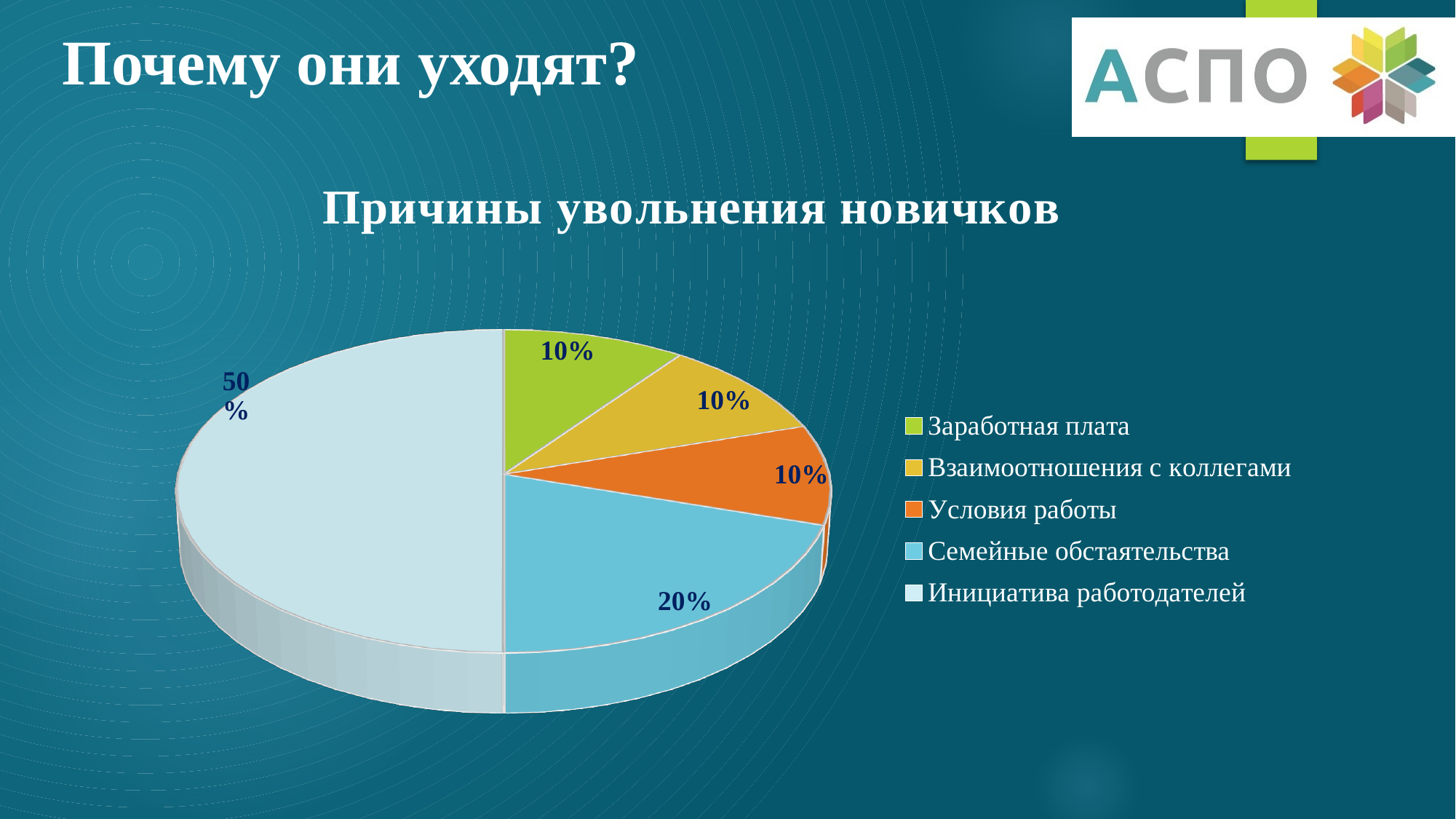
How many categories does the legend list? 5 What is the combined share of "Заработная плата", "Взаимоотношения с коллегами" and "Условия работы"? 30% What share of the pie does "Инициатива работодателей" take? 50% What is the value for "Заработная плата"? 10% What type of chart is shown on the slide? Pie chart Which colour represents "Условия работы" in the legend? Orange What is the value for "Условия работы"? 10% Which is larger, the value for "Семейные обстаятельства" or the value for "Взаимоотношения с коллегами"? Семейные обстаятельства What is the difference between the values for "Инициатива работодателей" and "Семейные обстаятельства"? 30% Which category has the largest slice of the pie? Инициатива работодателей What is the title of the chart? Причины увольнения новичков What is the value for "Семейные обстаятельства"? 20%